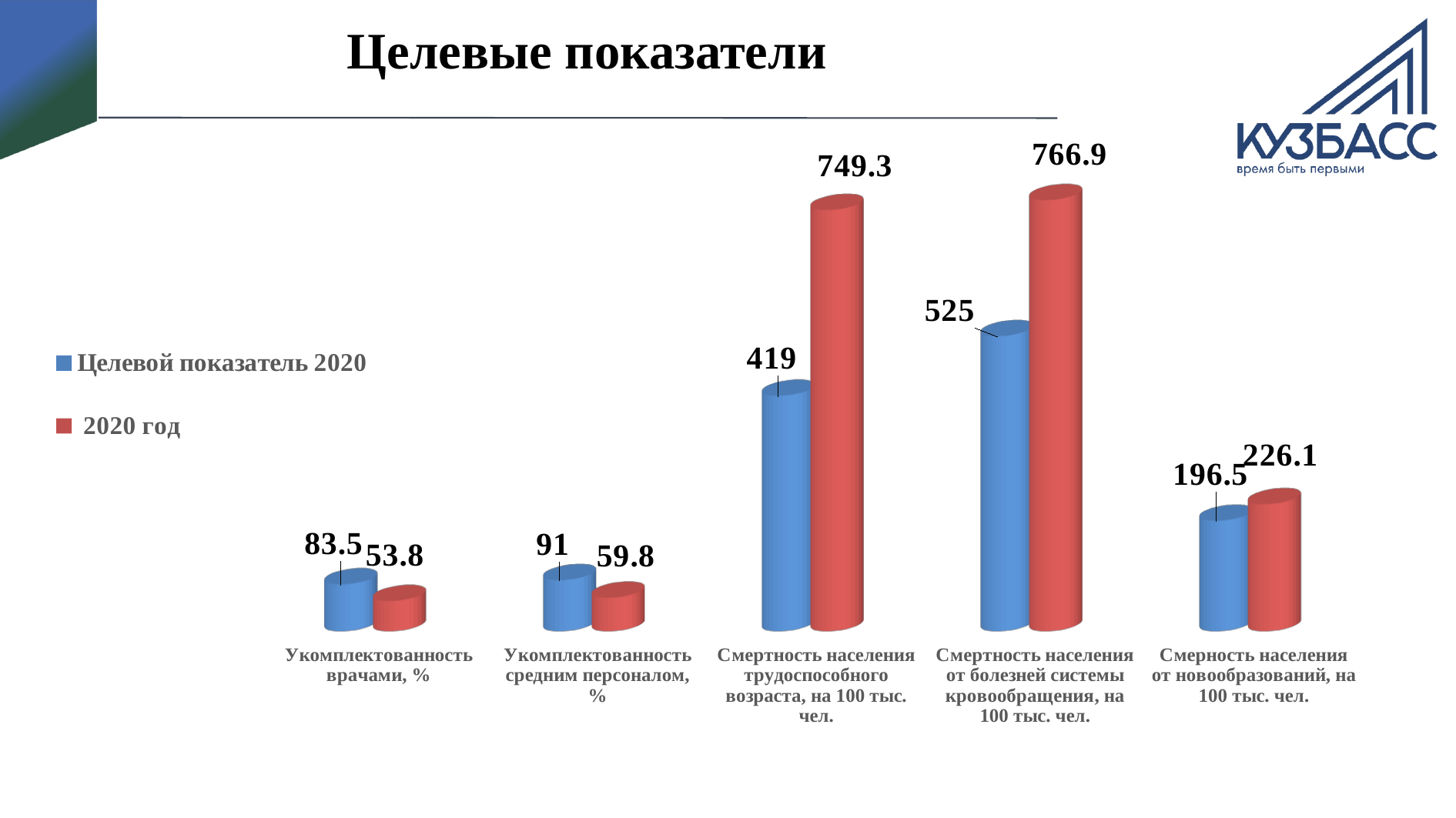
What is the difference between '2020 год' and 'Целевой показатель 2020' for 'Смертность населения от болезней системы кровообращения, на 100 тыс. чел.'? 241.9 What is the value of 'Целевой показатель 2020' for 'Укомплектованность врачами, %'? 83.5 What is the value of '2020 год' for 'Смертность населения трудоспособного возраста, на 100 тыс. чел.'? 749.3 How many categories are shown on the x axis of the chart? 5 What is the value of '2020 год' for 'Укомплектованность средним персоналом, %'? 59.8 What kind of chart is shown on the slide? Bar chart Which category has the lowest value in the '2020 год' series? Укомплектованность врачами, % What is the title of the slide containing the chart? Целевые показатели Which category has the highest value in the '2020 год' series? Смертность населения от болезней системы кровообращения, на 100 тыс. чел. For 'Укомплектованность средним персоналом, %', which is larger: 'Целевой показатель 2020' or '2020 год'? Целевой показатель 2020 What is the value of 'Целевой показатель 2020' for 'Смерность населения от новообразований, на 100 тыс. чел.'? 196.5 How many series does the legend list? 2